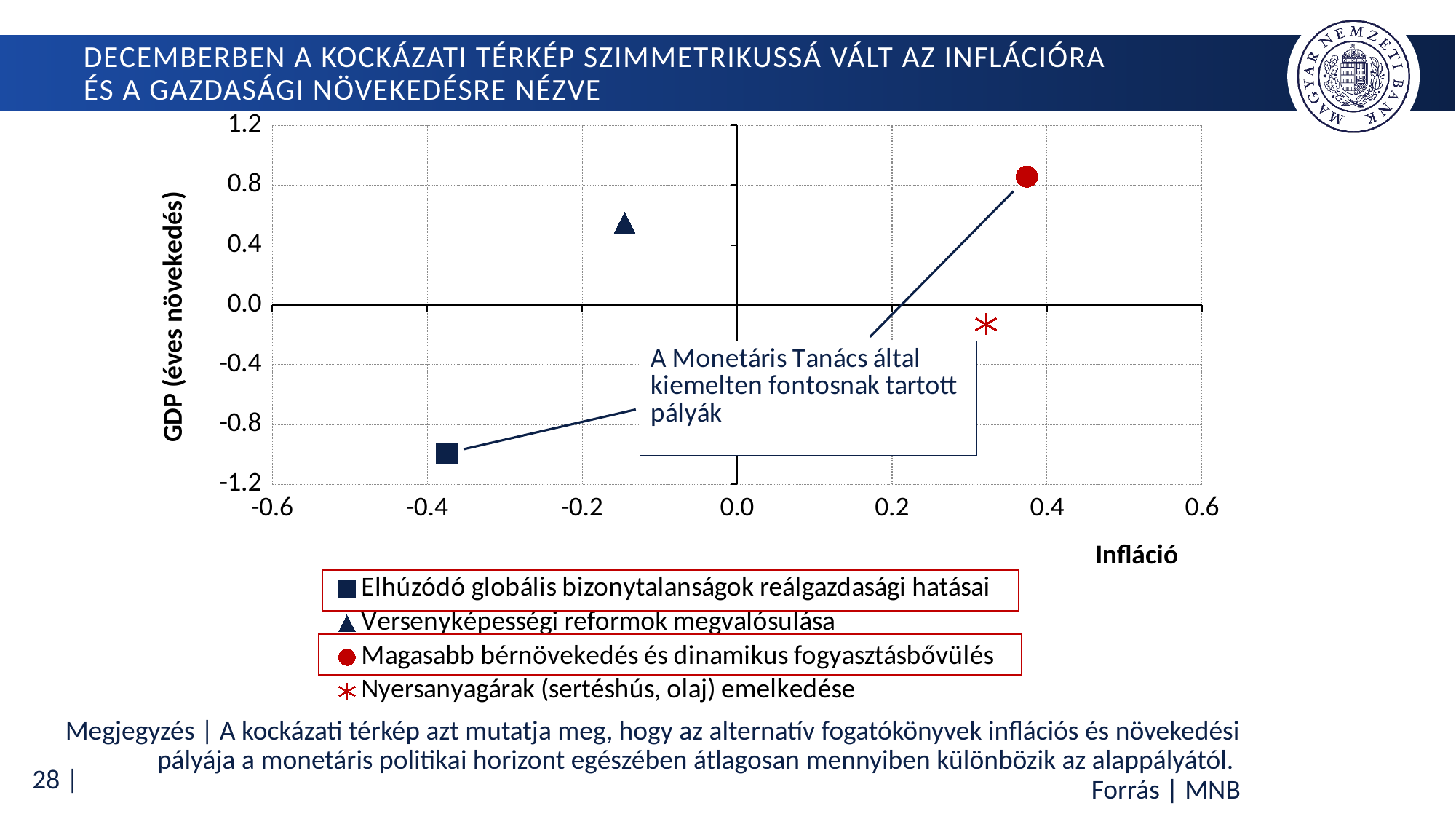
Is the Infláció value for Elhúzódó globális bizonytalanságok reálgazdasági hatásai greater or less than -0.2? less Is the GDP value for Elhúzódó globális bizonytalanságok reálgazdasági hatásai greater or less than -0.8? less Is the GDP value for Magasabb bérnövekedés és dinamikus fogyasztásbővülés greater or less than 0.4? greater Which series has the lowest Infláció value? Elhúzódó globális bizonytalanságok reálgazdasági hatásai What type of chart is shown on the slide? Scatter chart What is the label of the vertical axis of the chart? GDP (éves növekedés) How many series does the legend list? 4 Which series has the lowest GDP (éves növekedés) value? Elhúzódó globális bizonytalanságok reálgazdasági hatásai How many data points are plotted on the chart? 4 Which has a higher GDP value: Versenyképességi reformok megvalósulása or Magasabb bérnövekedés és dinamikus fogyasztásbővülés? Magasabb bérnövekedés és dinamikus fogyasztásbővülés Which series has the highest GDP (éves növekedés) value? Magasabb bérnövekedés és dinamikus fogyasztásbővülés Which has a higher Infláció value: Elhúzódó globális bizonytalanságok reálgazdasági hatásai or Versenyképességi reformok megvalósulása? Versenyképességi reformok megvalósulása